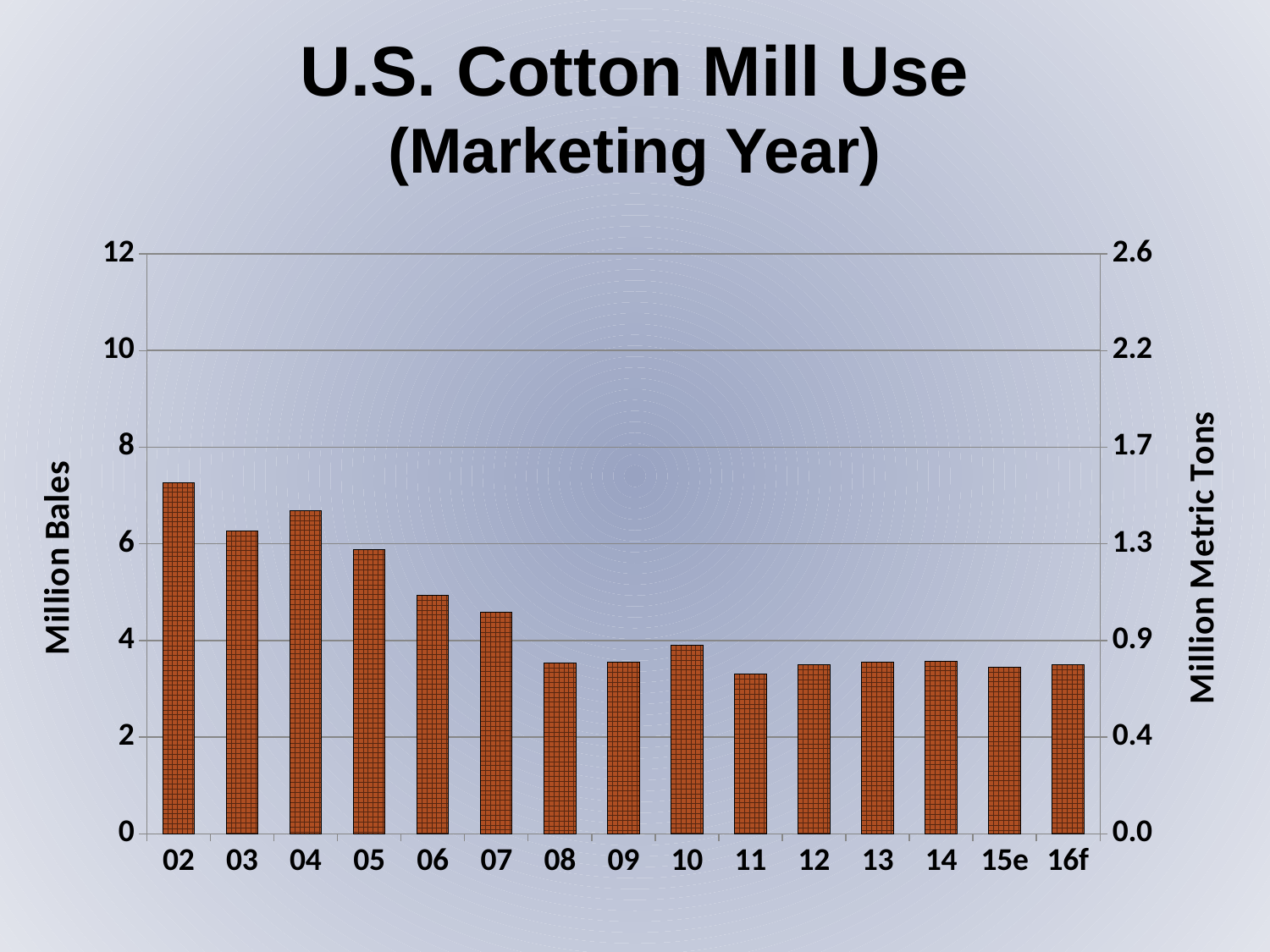
Which is larger, the value for 04 or the value for 05? 04 How many marketing years are plotted on the chart? 15 What is the label on the right-hand vertical axis? Million Metric Tons Is the value for 02 greater or less than 6 million bales? greater Do the values generally rise or fall from 02 to 16f? fall Which marketing year has the highest cotton mill use? 02 Which is larger, the value for 10 or the value for 11? 10 Is the value for 08 greater or less than 4 million bales? less Which is larger, the value for 02 or the value for 03? 02 What kind of chart is shown on the slide? bar chart Is the value for 06 greater or less than 4 million bales? greater